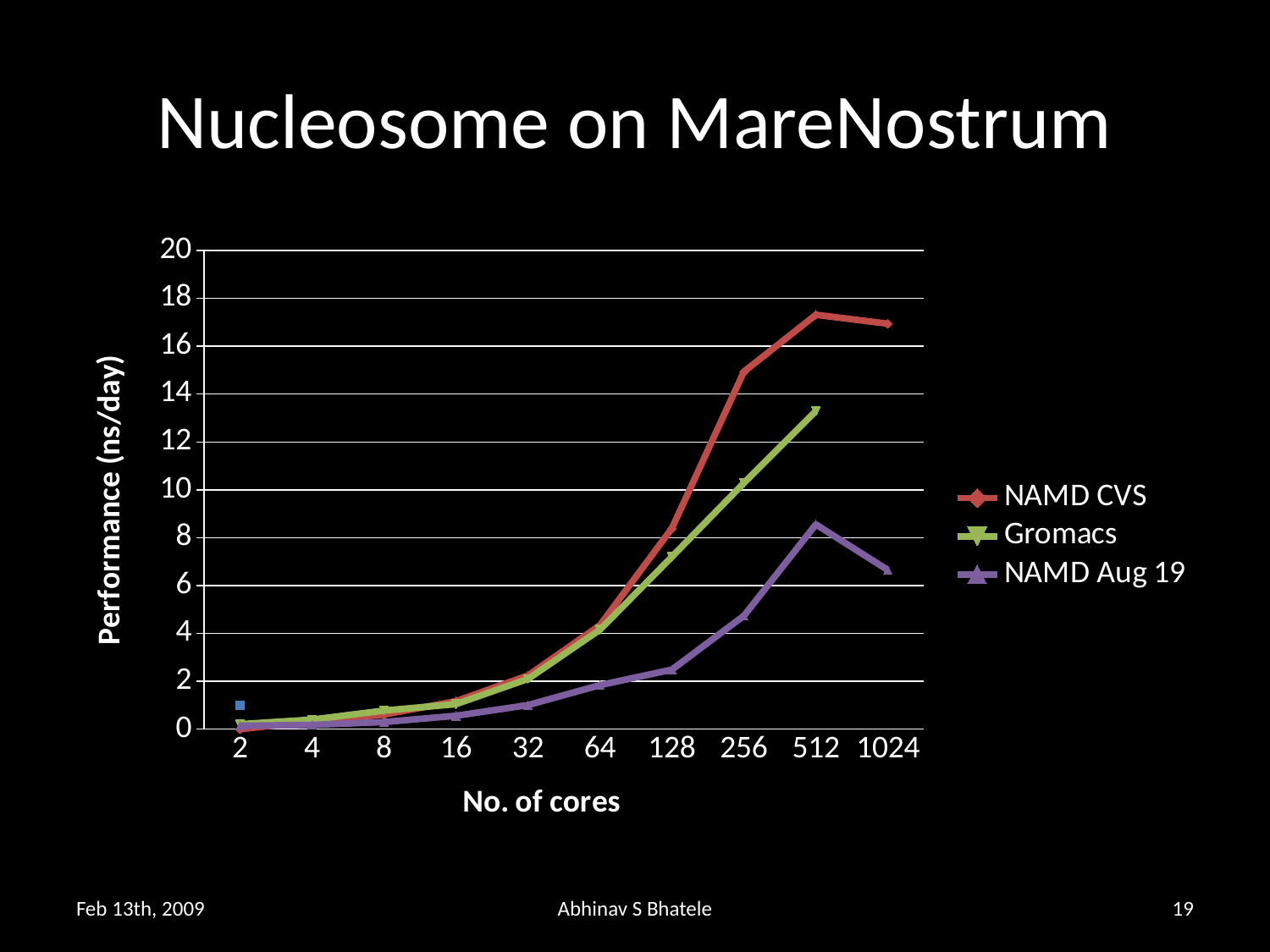
At 1024 cores, which is larger: NAMD CVS or NAMD Aug 19? NAMD CVS Is the value for NAMD CVS at 256 cores greater or less than 14? greater Does the NAMD Aug 19 series rise or fall between 512 and 1024 cores? fall Is the value for NAMD Aug 19 at 1024 cores greater or less than 8? less What is the label of the y axis? Performance (ns/day) How many series does the legend list? 3 What kind of chart is shown on the slide? line chart Is the value for Gromacs at 512 cores greater or less than 14? less Which series has the highest performance at 512 cores? NAMD CVS How many core counts are shown on the x axis? 10 Which series has the lowest performance at 512 cores? NAMD Aug 19